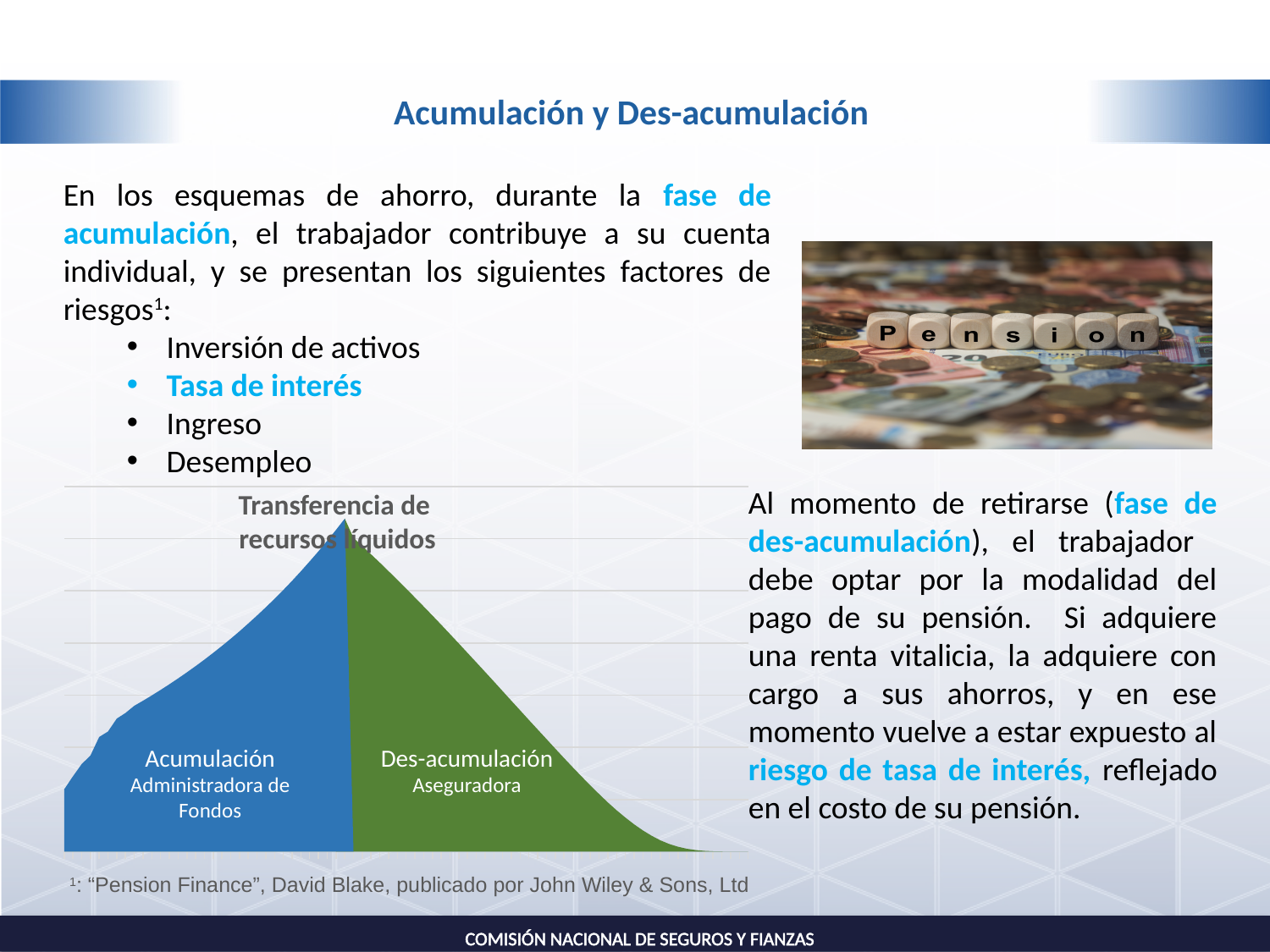
In the chart at the bottom left, do the values rise or fall along the x axis during the Des-acumulación phase? Fall In the chart at the bottom left, which entity is named under the Des-acumulación phase? Aseguradora In the chart at the bottom left, which entity is named under the Acumulación phase? Administradora de Fondos In the chart at the bottom left, do the values rise or fall along the x axis during the Acumulación phase? Rise What kind of chart is shown at the bottom left of the slide? Area chart In the chart at the bottom left, what label is placed at the peak between the two phases? Transferencia de recursos líquidos In the chart at the bottom left, what colour is the Acumulación region? Blue In the chart at the bottom left, which phase comes first along the x axis, Acumulación or Des-acumulación? Acumulación How many phases (regions) does the chart at the bottom left of the slide show? 2